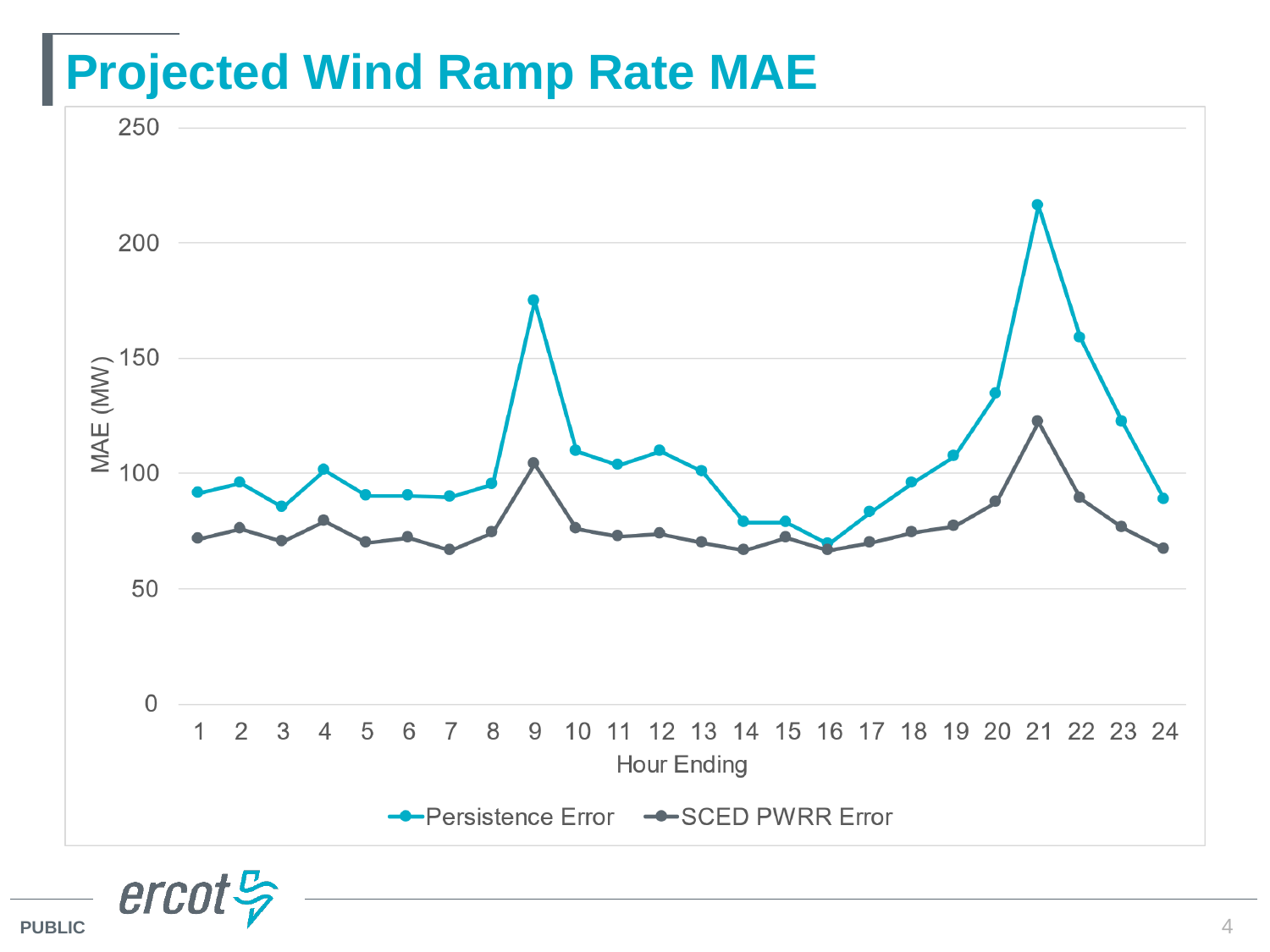
Is the SCED PWRR Error at hour ending 1 greater or less than 100? less At hour ending 9, which series has the larger value, Persistence Error or SCED PWRR Error? Persistence Error Is the Persistence Error at hour ending 9 greater or less than 150? greater What kind of chart is shown on the slide? Line chart Is the Persistence Error at hour ending 21 greater or less than 200? greater At which hour ending does the SCED PWRR Error reach its highest value? 21 How many series does the legend list? 2 What is the label on the y axis of the chart? MAE (MW) At which hour ending does the Persistence Error reach its highest value? 21 At which hour ending is the Persistence Error lowest? 16 Does the Persistence Error rise or fall from hour ending 21 to hour ending 24? Fall How many hours are plotted along the x axis? 24